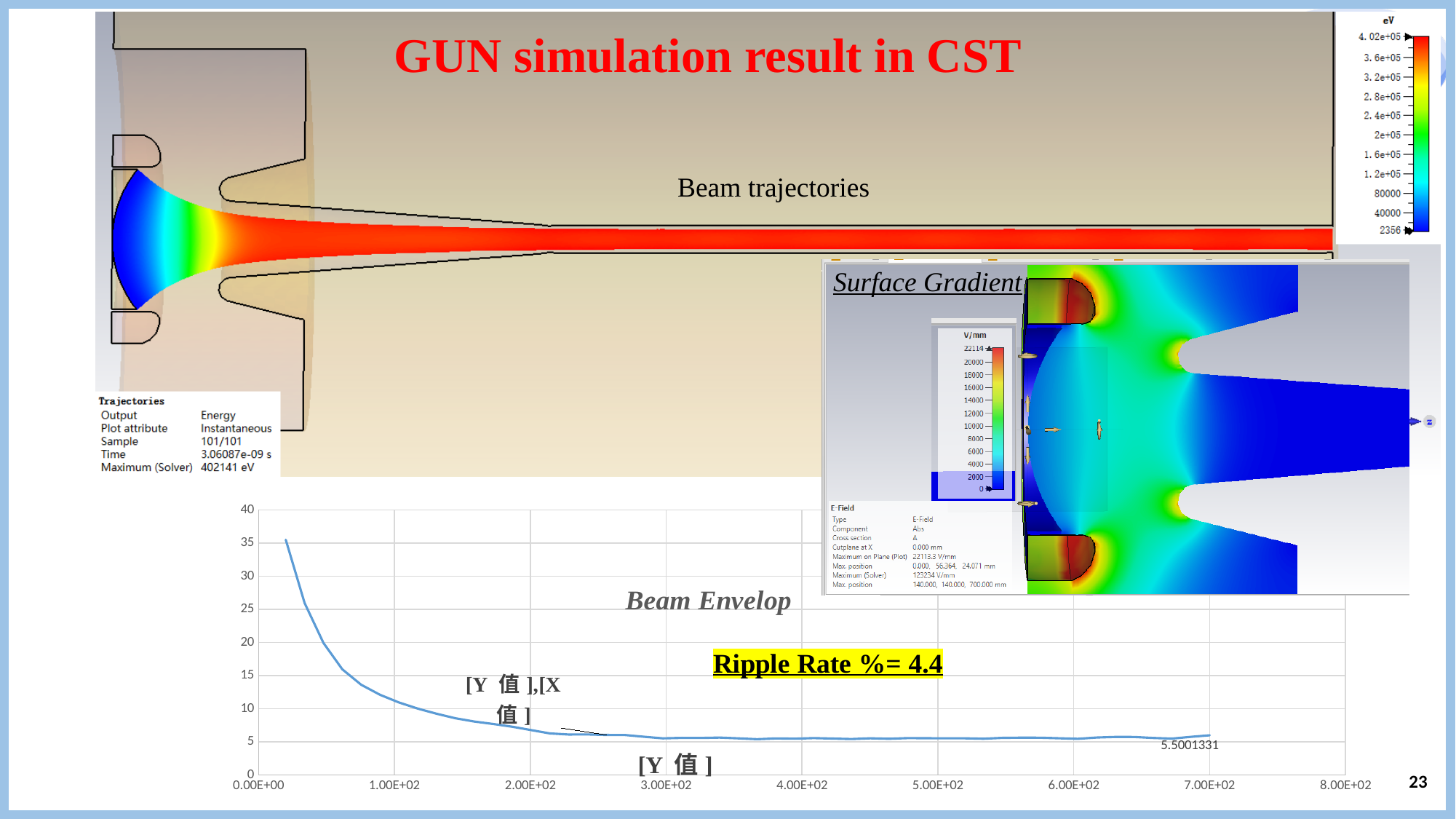
In the Beam Envelop chart, is the value at x = 3.00E+02 greater or less than 10? less What is the title shown on the line chart at the bottom of the slide? Beam Envelop In the Beam Envelop chart, is the starting value of the line (near x = 0) greater or less than 30? greater In the Beam Envelop chart, which is larger: the value at x = 1.00E+02 or the value at x = 6.00E+02? the value at x = 1.00E+02 What is the highest tick value shown on the y axis of the Beam Envelop chart? 40 What value is printed as the data label at the right end of the Beam Envelop line? 5.5001331 In the Beam Envelop chart, do the values rise or fall as the x axis increases? fall In the Beam Envelop chart, is the value at x = 2.00E+02 greater or less than 15? less What kind of chart is the Beam Envelop chart at the bottom of the slide? line chart